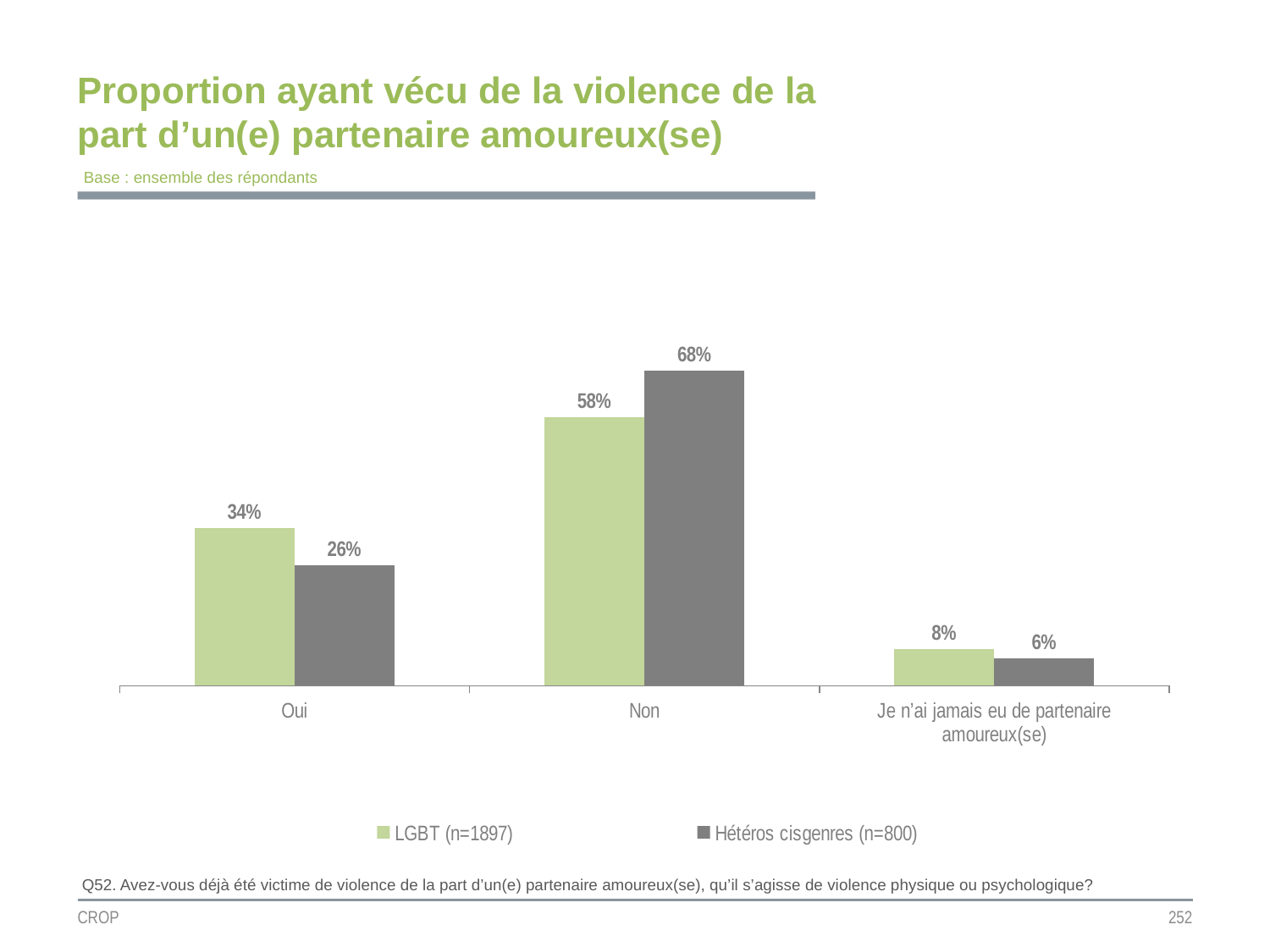
What is the difference between the Hétéros cisgenres (n=800) and LGBT (n=1897) values in the Non category? 10% What is the value for LGBT (n=1897) in the Oui category? 34% What is the value for Hétéros cisgenres (n=800) in the Non category? 68% Which category has the highest value for the LGBT (n=1897) series? Non Which category has the lowest value for the Hétéros cisgenres (n=800) series? Je n'ai jamais eu de partenaire amoureux(se) In the Oui category, which series has the larger value, LGBT (n=1897) or Hétéros cisgenres (n=800)? LGBT (n=1897) What kind of chart is shown on the slide? Bar chart What is the value for LGBT (n=1897) in the 'Je n'ai jamais eu de partenaire amoureux(se)' category? 8% What is the difference between the LGBT (n=1897) and Hétéros cisgenres (n=800) values in the Oui category? 8% How many categories are shown on the x axis? 3 What is the value for Hétéros cisgenres (n=800) in the Oui category? 26% How many series does the legend list? 2